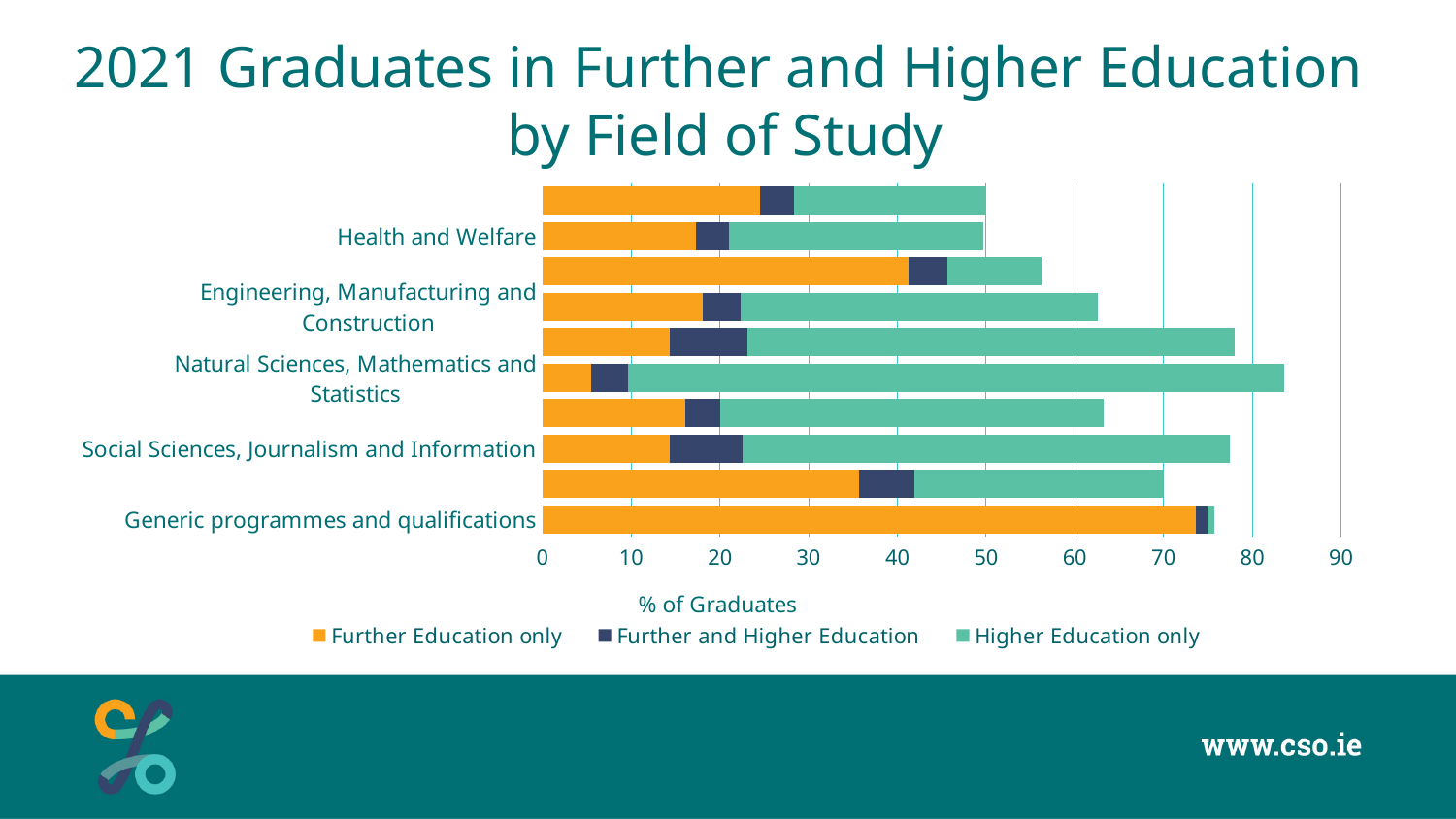
What is the x-axis title of the chart? % of Graduates Is the total bar for Social Sciences, Journalism and Information greater or less than 70? greater How many series does the legend list? 3 Which labelled field of study has the longest total bar? Natural Sciences, Mathematics and Statistics Is the total bar for Natural Sciences, Mathematics and Statistics greater or less than 80? greater Is the 'Further Education only' value for Health and Welfare greater or less than 20? less Which labelled field of study has the largest 'Further Education only' segment? Generic programmes and qualifications How many bars are plotted in the chart? 10 Which legend entry is shown in orange? Further Education only Which has the longer total bar: Natural Sciences, Mathematics and Statistics or Health and Welfare? Natural Sciences, Mathematics and Statistics What kind of chart is shown on the slide? Stacked bar chart